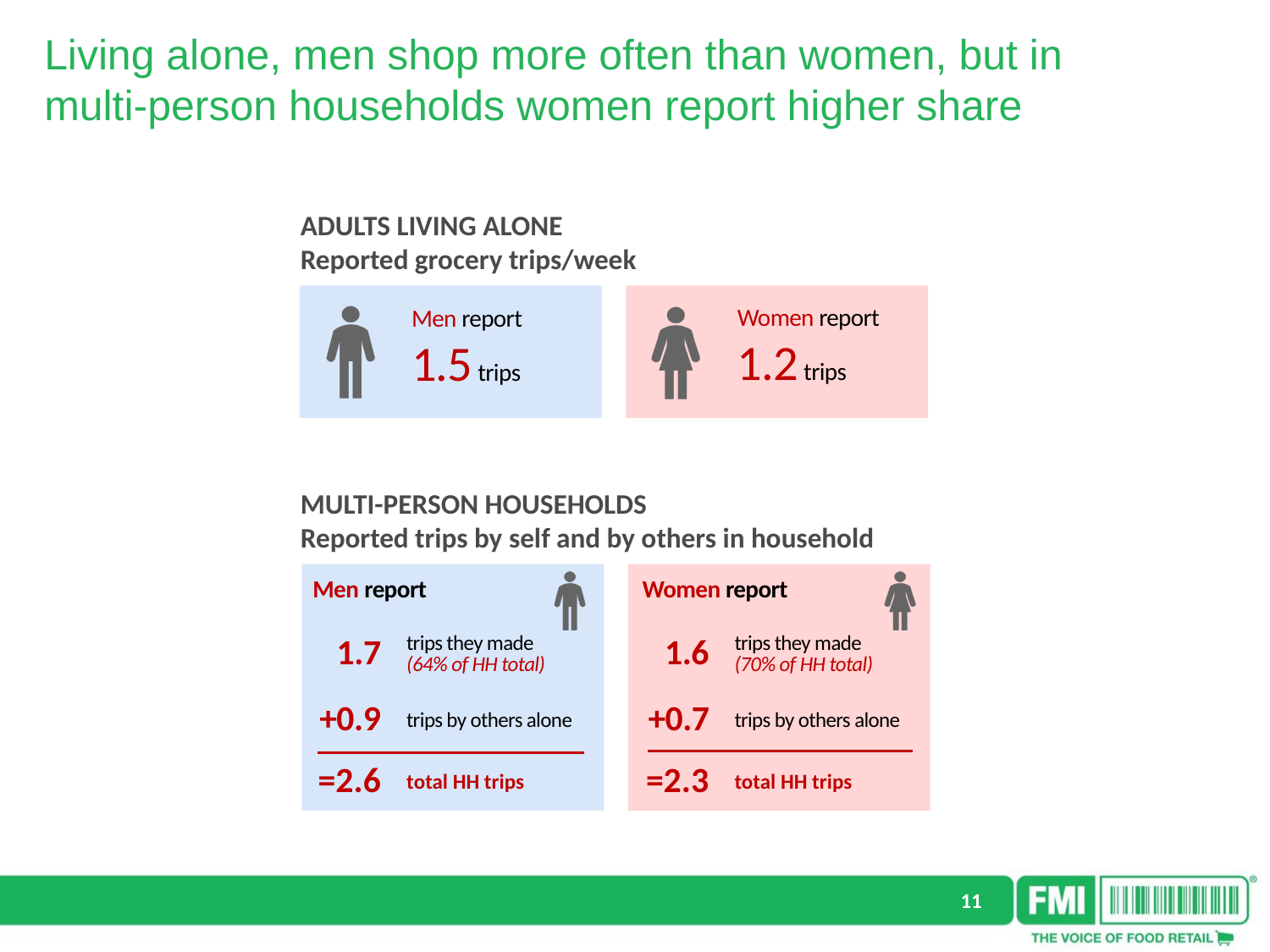
In the 'Multi-person households' section, what share of household total trips do men report making themselves? 64% of HH total In the 'Multi-person households' section, what is the total household trips figure reported by women? 2.3 In the 'Adults living alone' section, what is the difference between the trips reported by men and by women? 0.3 trips In the 'Multi-person households' section, how many trips do women report they made themselves? 1.6 In the 'Adults living alone' section, who reports more grocery trips per week, men or women? Men In the 'Multi-person households' section, how many trips do men report they made themselves? 1.7 What is the subtitle under 'Multi-person households'? Reported trips by self and by others in household In the 'Multi-person households' section, how many trips by others alone do men report? +0.9 In the 'Multi-person households' section, what share of household total trips do women report making themselves? 70% of HH total In the 'Adults living alone' section, how many grocery trips per week do men report? 1.5 trips In the 'Adults living alone' section, how many grocery trips per week do women report? 1.2 trips In the 'Multi-person households' section, what is the total household trips figure reported by men? 2.6